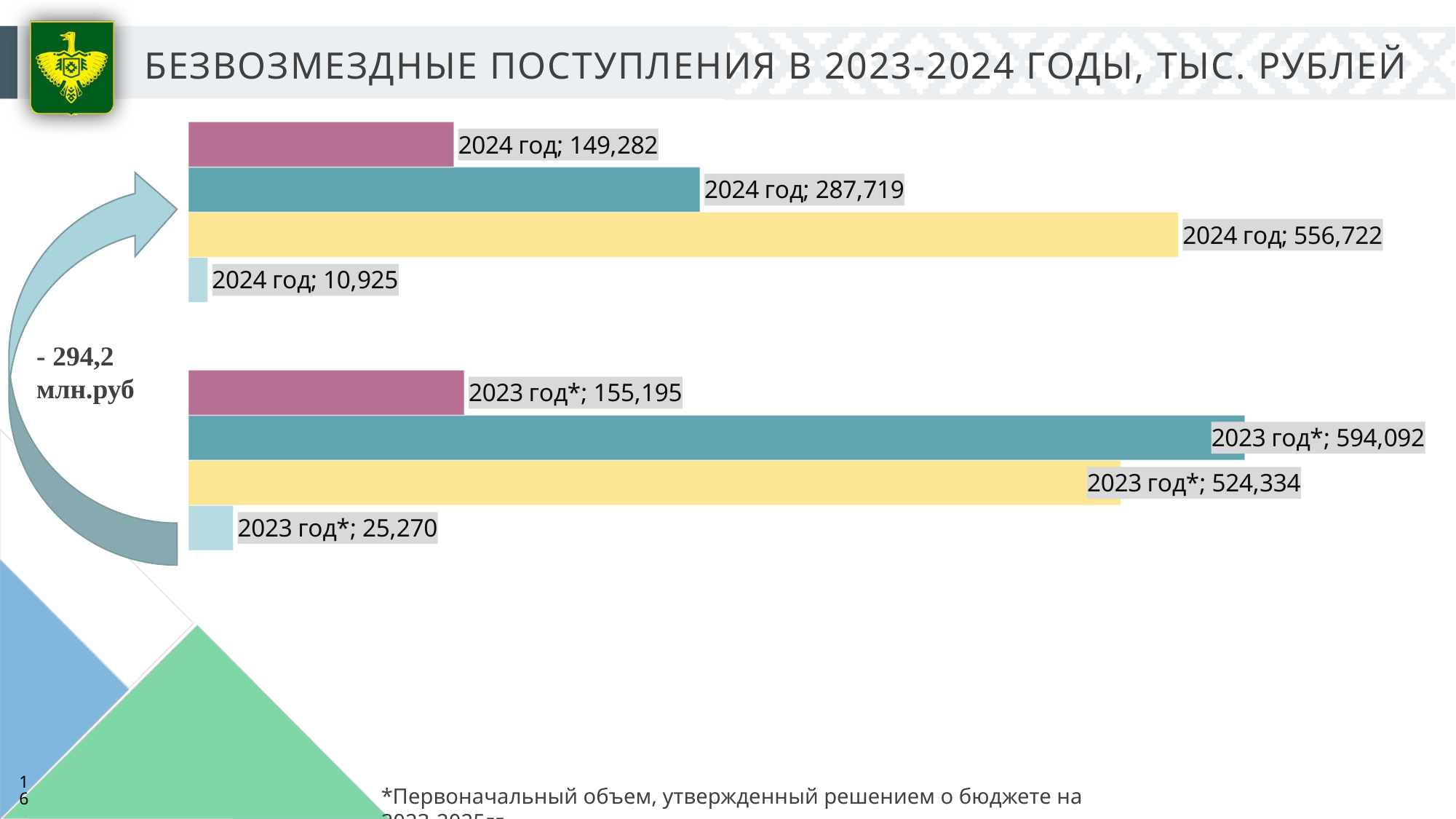
What is the value of the teal bar for 2023 год*? 594,092 Which bar in the 2023 год* group has the lowest value? the light blue bar (25,270) What is the value of the light blue bar for 2024 год? 10,925 Which bar in the 2024 год group has the highest value? the yellow bar (556,722) What is the difference between the yellow bar values for 2024 год and 2023 год*? 32,388 In the 2023 год* group, which is larger: the teal bar or the yellow bar? the teal bar What is the value of the purple bar for 2023 год*? 155,195 What is the title of the slide containing the chart? БЕЗВОЗМЕЗДНЫЕ ПОСТУПЛЕНИЯ В 2023-2024 ГОДЫ, ТЫС. РУБЛЕЙ What is the value of the yellow bar for 2024 год? 556,722 What type of chart is shown on the slide? bar chart What is the difference between the teal bar values for 2023 год* and 2024 год? 306,373 How many bars are plotted in the chart in total? 8